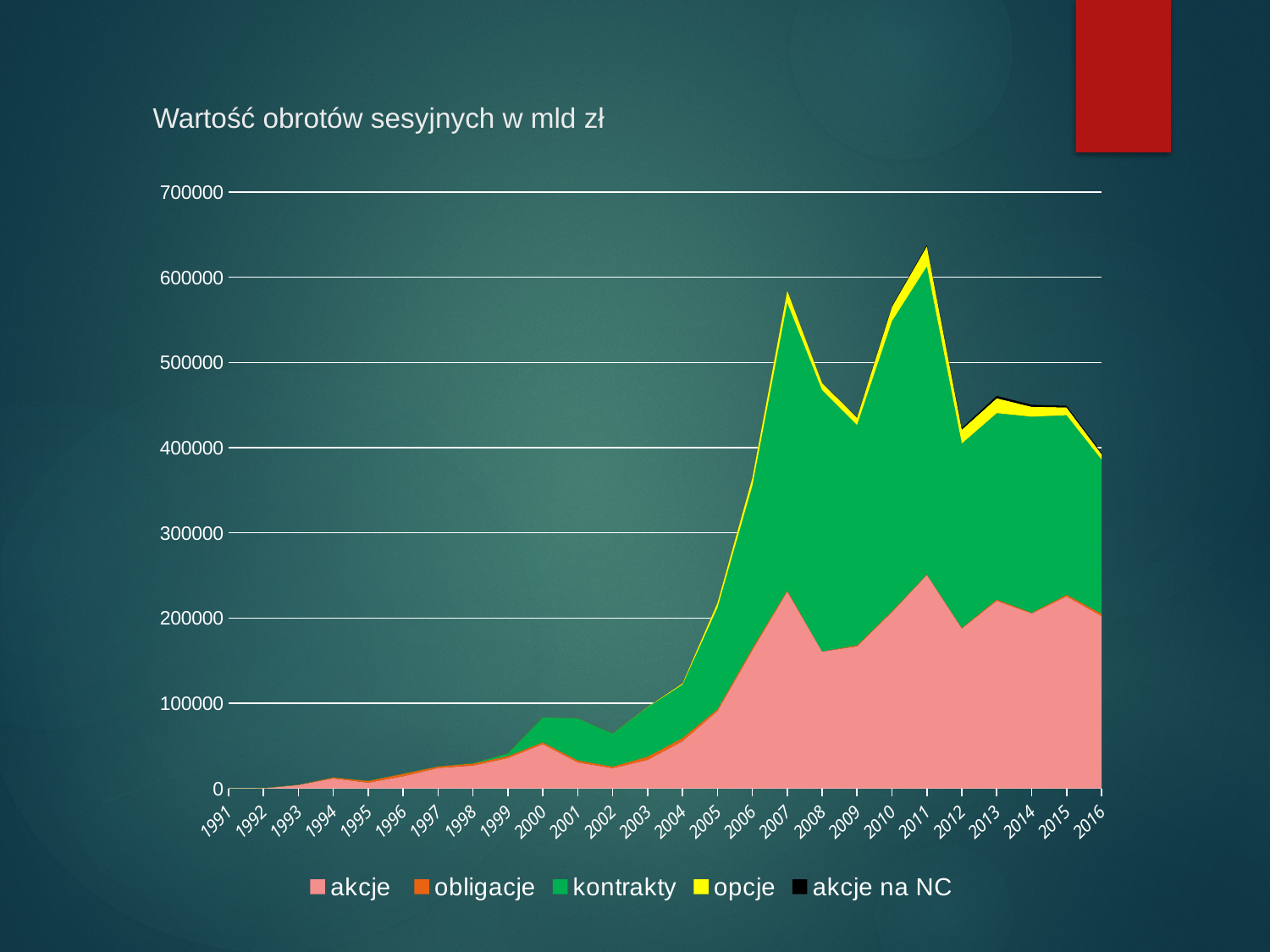
Does the total value rise or fall from 2011 to 2012? fall What kind of chart is shown on the slide? Stacked area chart Is the total value for 2011 greater or less than 600000? greater Is the value for akcje in 2011 greater or less than 200000? greater Is the total value for 2007 greater or less than 500000? greater Which is larger, the total value for 2011 or the total value for 2007? 2011 Which year has the highest total value? 2011 What is the title of the chart? Wartość obrotów sesyjnych w mld zł How many series does the legend list? 5 How many years are shown on the x axis? 26